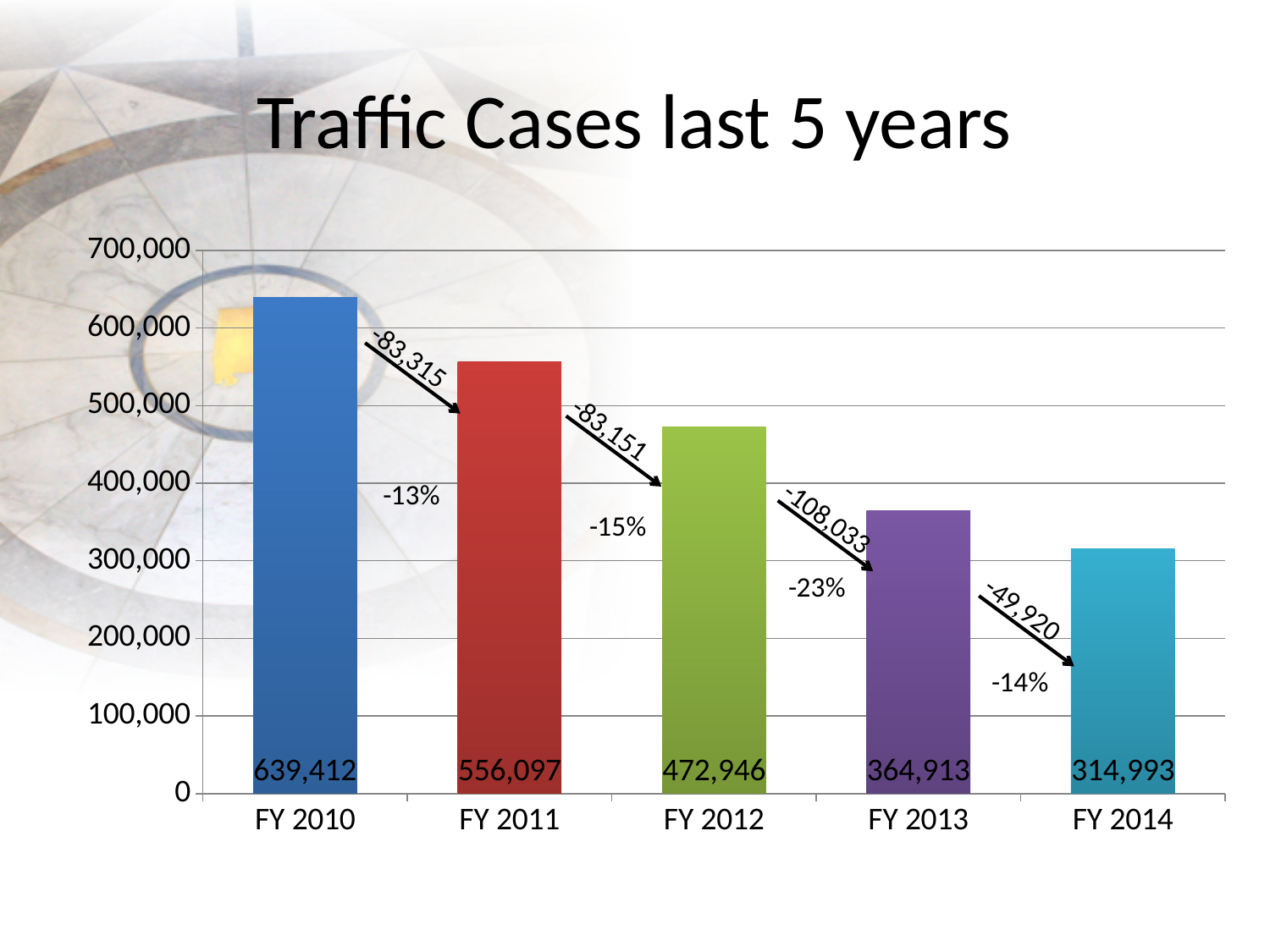
Do the traffic case values rise or fall from FY 2010 to FY 2014? fall How many fiscal years are shown on the chart? 5 What is the number of traffic cases for FY 2014? 314,993 What is the difference in traffic cases between FY 2012 and FY 2013? 108,033 What kind of chart is shown on the slide? bar chart What is the number of traffic cases for FY 2010? 639,412 Which fiscal year has the lowest number of traffic cases? FY 2014 What is the difference in traffic cases between FY 2010 and FY 2011? 83,315 Is the value for FY 2013 greater or less than 400,000? less What is the number of traffic cases for FY 2012? 472,946 Which fiscal year has the highest number of traffic cases? FY 2010 Which has more traffic cases, FY 2011 or FY 2013? FY 2011